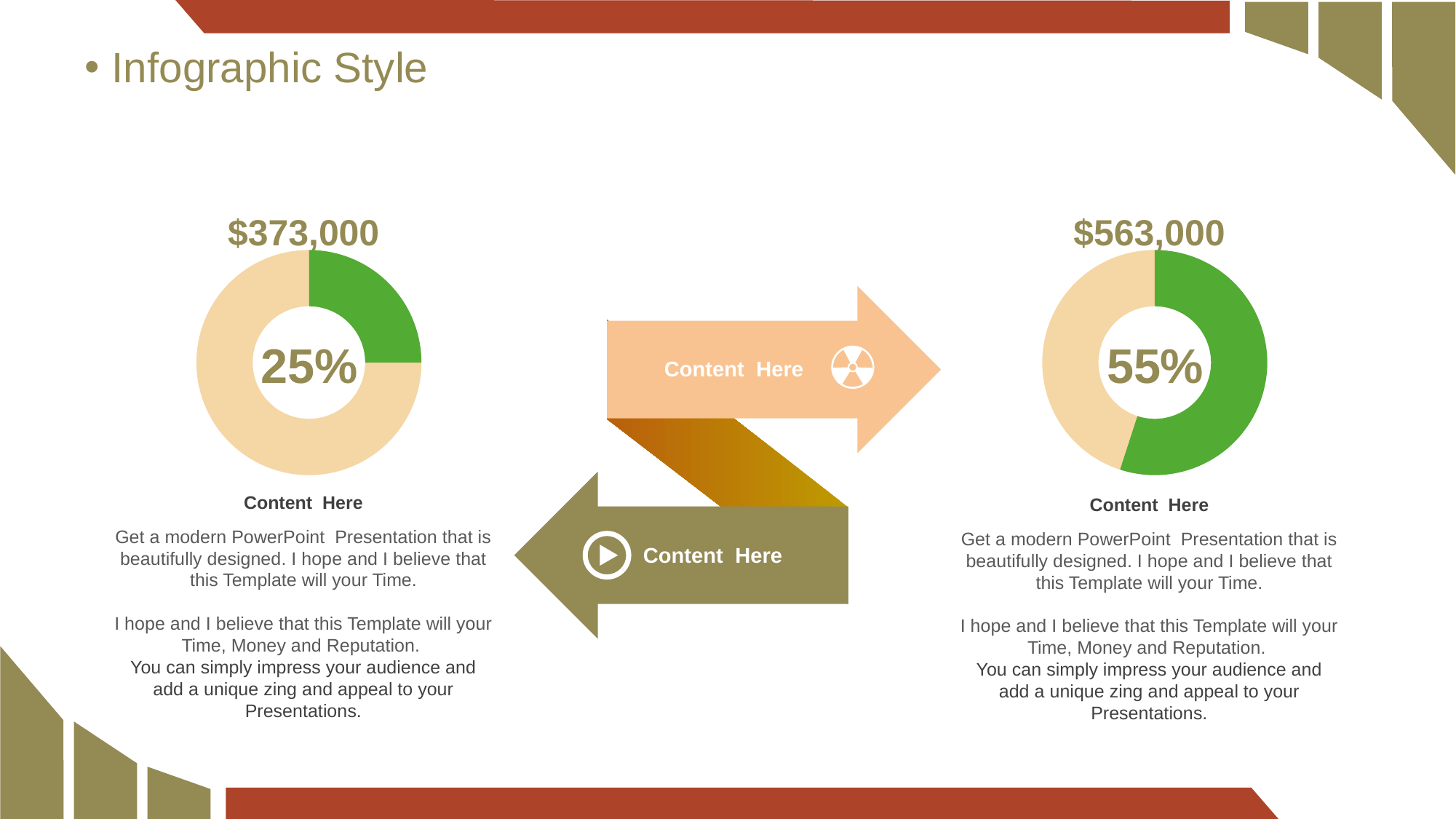
What is the title of the slide containing the two doughnut charts? Infographic Style How many doughnut charts are on the slide? 2 What dollar value is printed above the right doughnut chart? $563,000 What percentage is shown in the centre of the left doughnut chart labelled $373,000? 25% What colour is the highlighted segment in both doughnut charts? Green What dollar value is printed above the left doughnut chart? $373,000 By how many percentage points does the right chart's 55% exceed the left chart's 25%? 30 percentage points What percentage is shown in the centre of the right doughnut chart labelled $563,000? 55% What share of the left doughnut chart does the green segment represent? 25% What is the difference between the dollar values shown above the two doughnut charts? $190,000 Which doughnut chart shows the larger percentage, the left one ($373,000) or the right one ($563,000)? The right one ($563,000) What kind of chart is used on this slide to show the 25% and 55% values? Doughnut (pie) chart